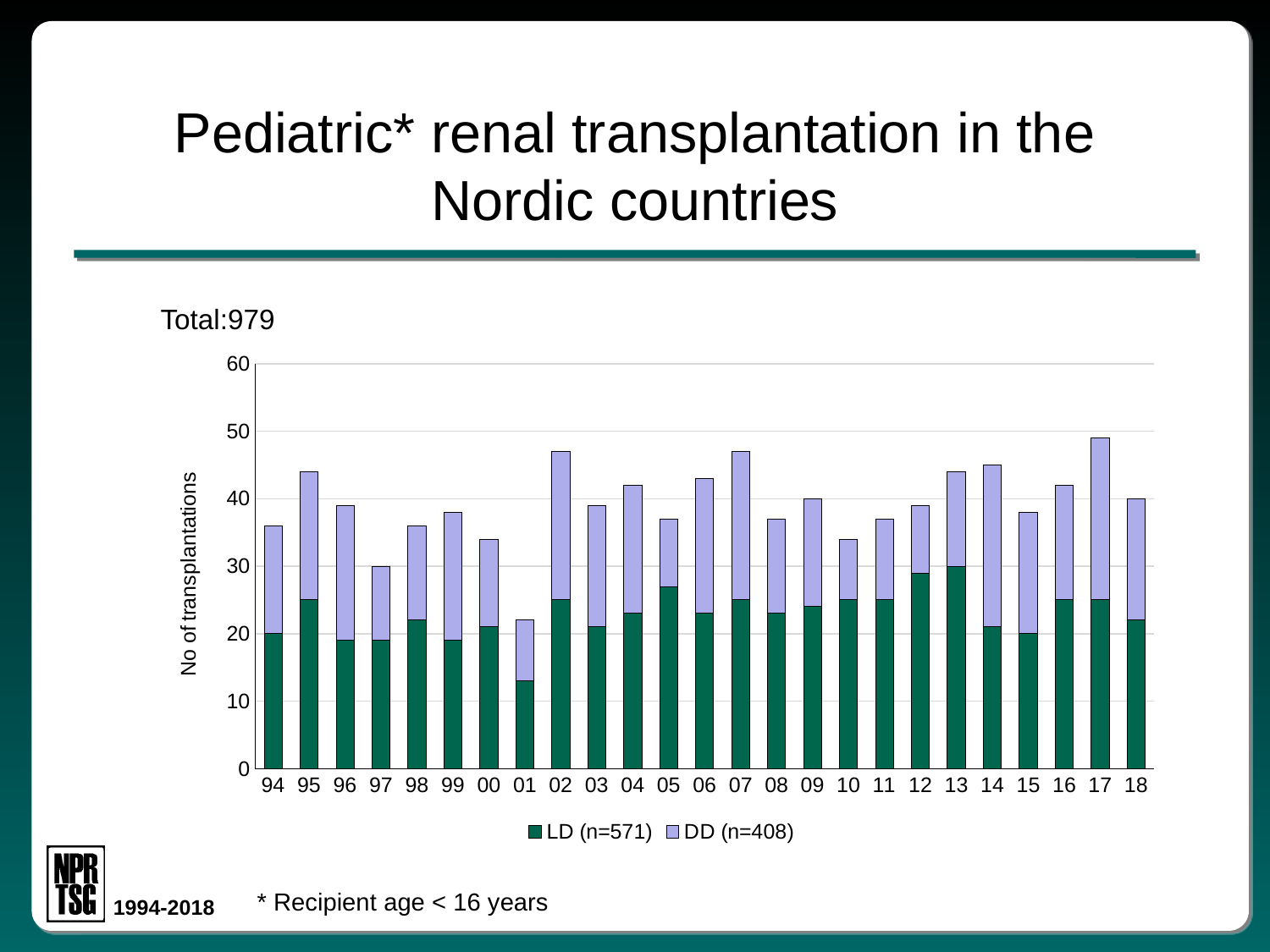
How many series does the chart's legend list? 2 Which year has the lowest total number of transplantations? 01 What kind of chart is shown on the slide? stacked bar chart Which year has the larger total number of transplantations, 02 or 01? 02 Which year has the smallest LD (living donor) segment? 01 Is the total number of transplantations in 01 greater or less than 30? less What total number of transplantations is stated above the chart? 979 What are the two legend entries of the chart? LD (n=571) and DD (n=408) How many years (categories) are shown on the x axis of the chart? 25 Is the total number of transplantations in 17 greater or less than 40? greater Is the total number of transplantations in 94 greater or less than 40? less